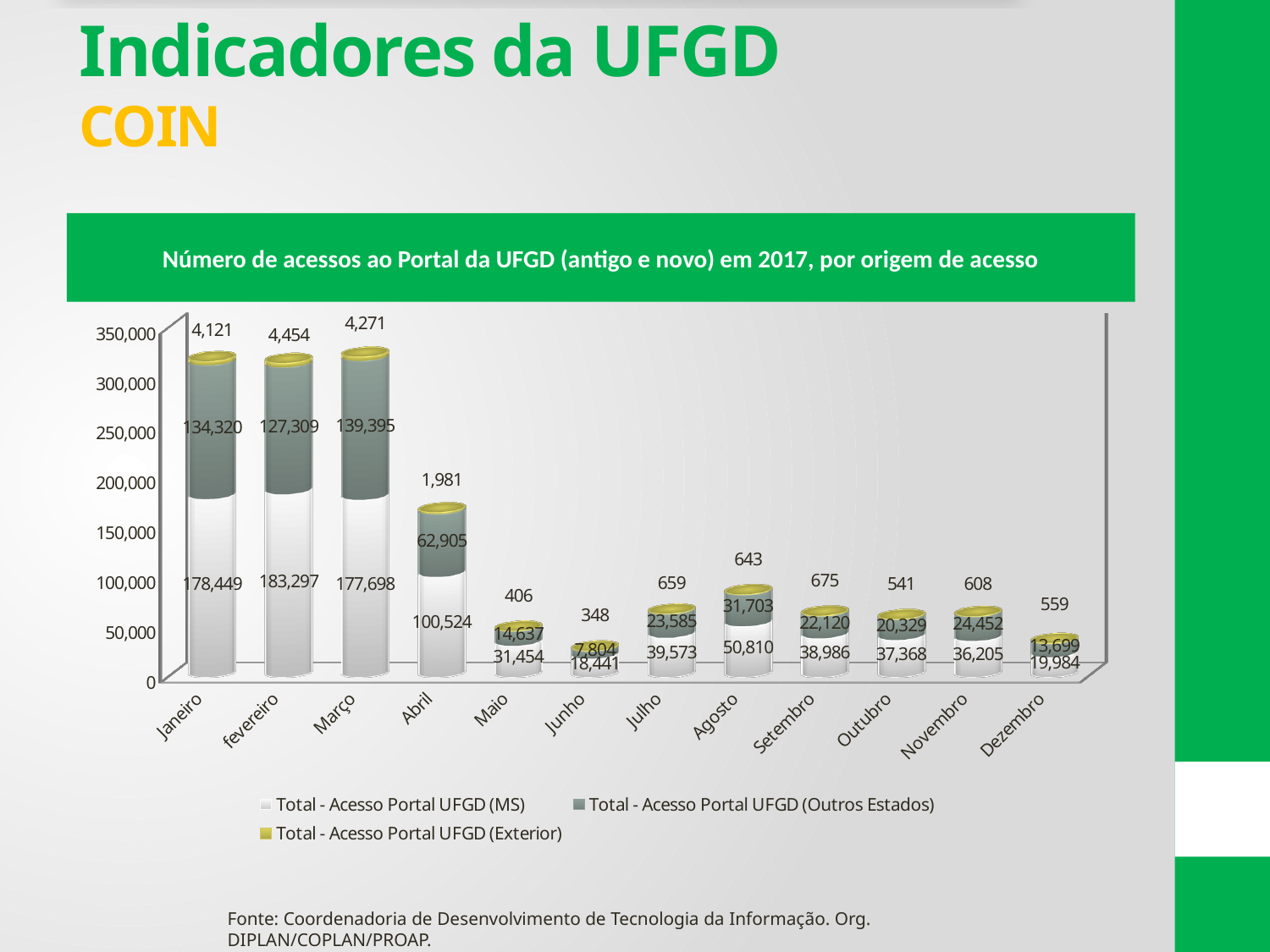
Which month has the lowest value for Total - Acesso Portal UFGD (Exterior)? Junho Which month has the highest value for Total - Acesso Portal UFGD (MS)? fevereiro Which is larger: the Outros Estados value in Agosto or the Outros Estados value in Julho? Agosto How many series does the legend list? 3 What is the value for Total - Acesso Portal UFGD (Outros Estados) in Março? 139,395 What is the total stacked value for Junho? 26,593 What is the value for Total - Acesso Portal UFGD (Exterior) in Abril? 1,981 What kind of chart is shown on the slide? Stacked bar chart How many months are shown on the x axis? 12 What is the difference between the MS value and the Outros Estados value in Janeiro? 44,129 What is the value for Total - Acesso Portal UFGD (MS) in Janeiro? 178,449 Is the total stacked value for Abril greater or less than 150,000? greater